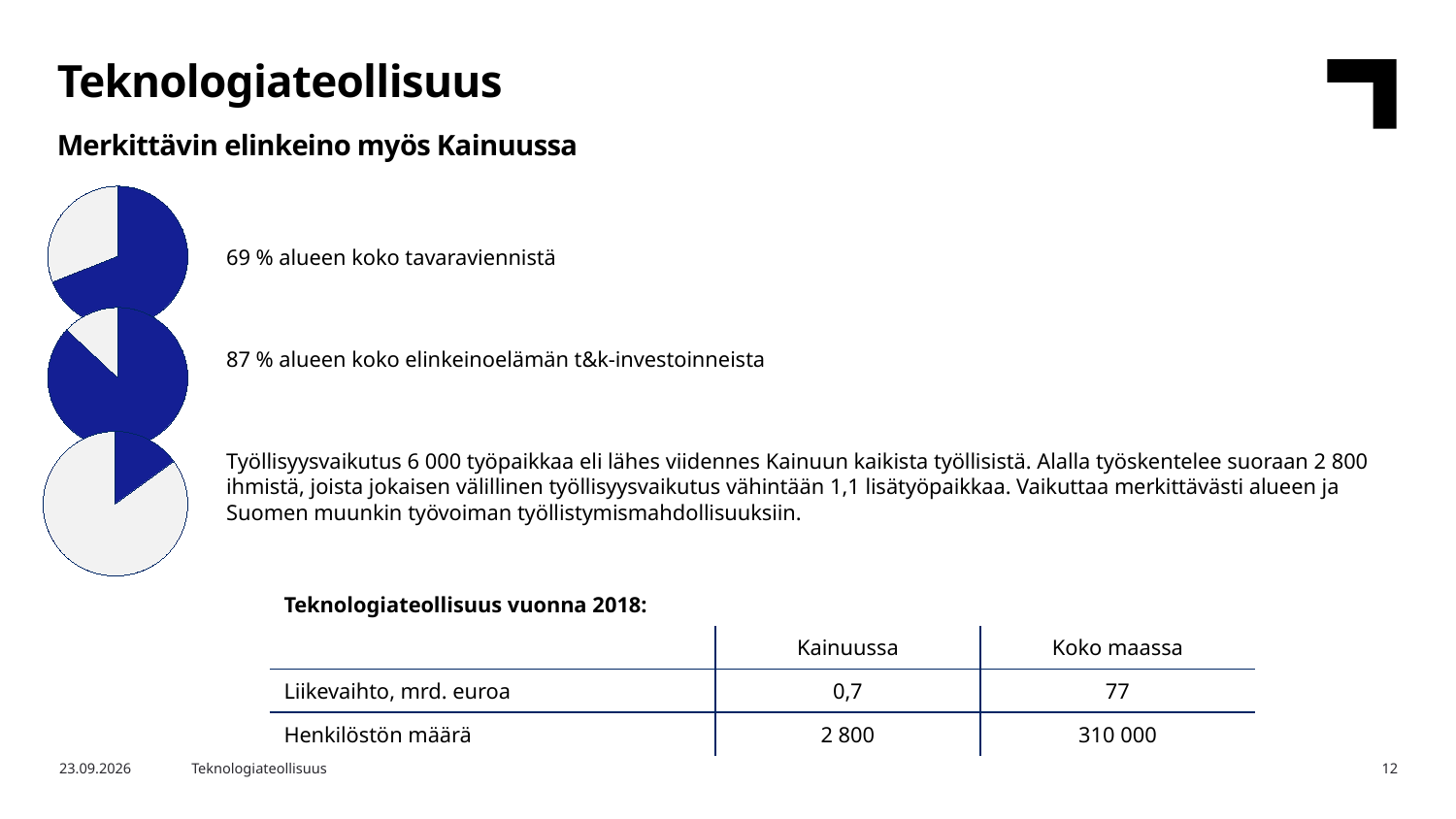
Is the blue slice in the top pie chart larger or smaller than the blue slice in the middle pie chart? Smaller In the middle pie chart, what share of the region's business R&D investments (t&k-investoinnit) does the blue slice represent? 87 % Is the blue slice in the bottom pie chart more or less than half of the pie? Less What colour is the highlighted slice in the pie charts? Blue Which pie chart has the smallest blue slice: the top, middle or bottom one? Bottom What kind of charts are shown on the left side of the slide? Pie charts What is the difference in percentage points between the shares shown for the middle pie chart (87 %) and the top pie chart (69 %)? 18 percentage points How many pie charts are on the slide? 3 In the top pie chart, what share of the region's total goods exports (tavaravienti) does the blue slice represent? 69 % How many slices does each pie chart have? 2 Which pie chart has the largest blue slice: the top, middle or bottom one? Middle